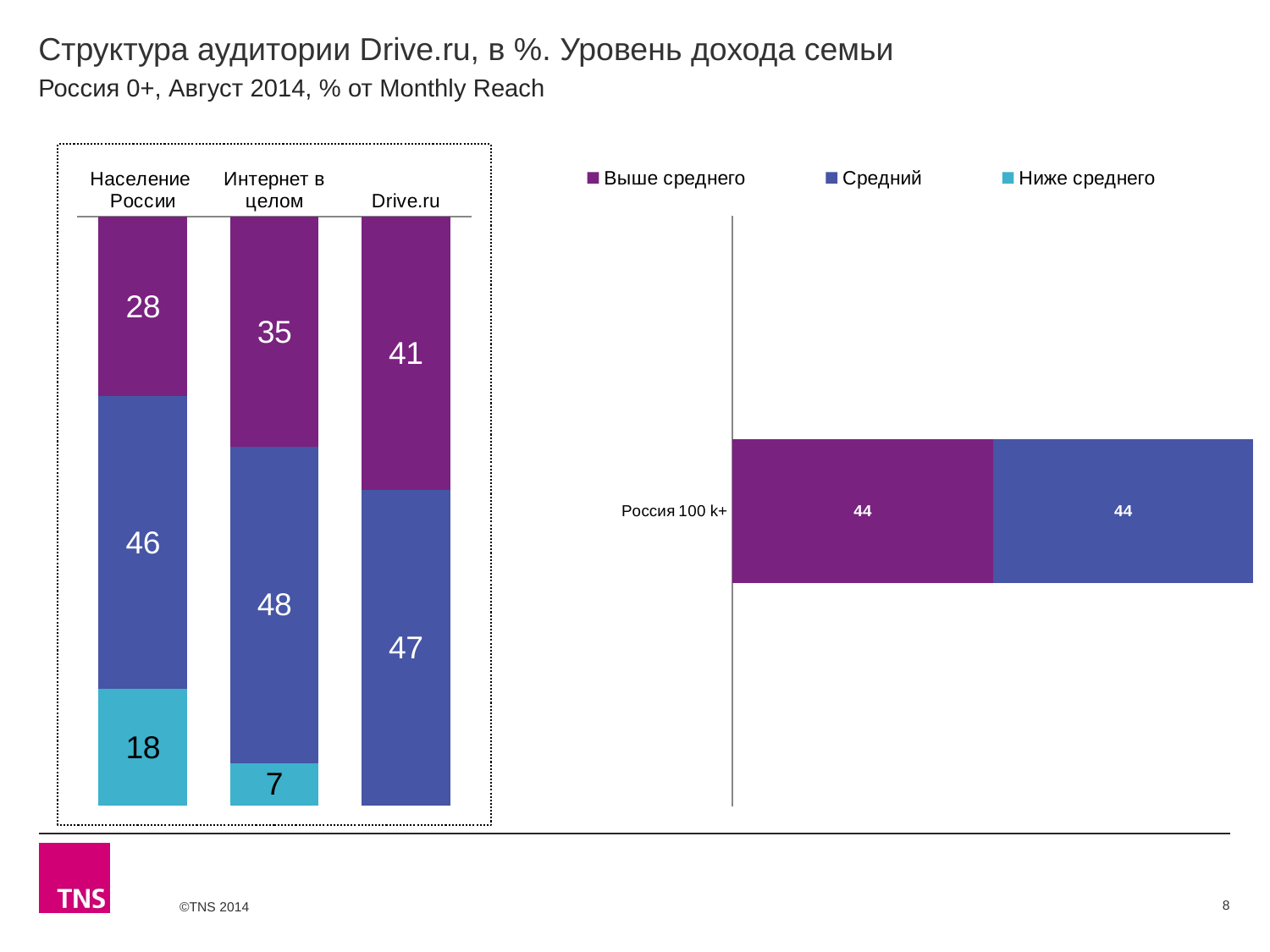
On the left chart, what is the value of the Средний segment for Интернет в целом? 48 On the left chart, what is the total of the three printed segments for Население России? 92 What kind of chart is the chart on the right? Stacked bar chart On the left chart, which category has the highest Выше среднего value? Drive.ru On the left chart, what is the value of the Ниже среднего segment for Население России? 18 On the right chart, what is the Средний value for Россия 100 k+? 44 On the left chart, how many categories are shown on the x axis? 3 On the left chart, which is larger: the Средний value for Население России or for Drive.ru? Drive.ru On the left chart, what is the difference between the Выше среднего values for Drive.ru and Население России? 13 On the left chart, what is the value of the Выше среднего segment for Drive.ru? 41 How many series does the legend list? 3 On the left chart, which category has the lowest Ниже среднего value among those with a printed label? Интернет в целом